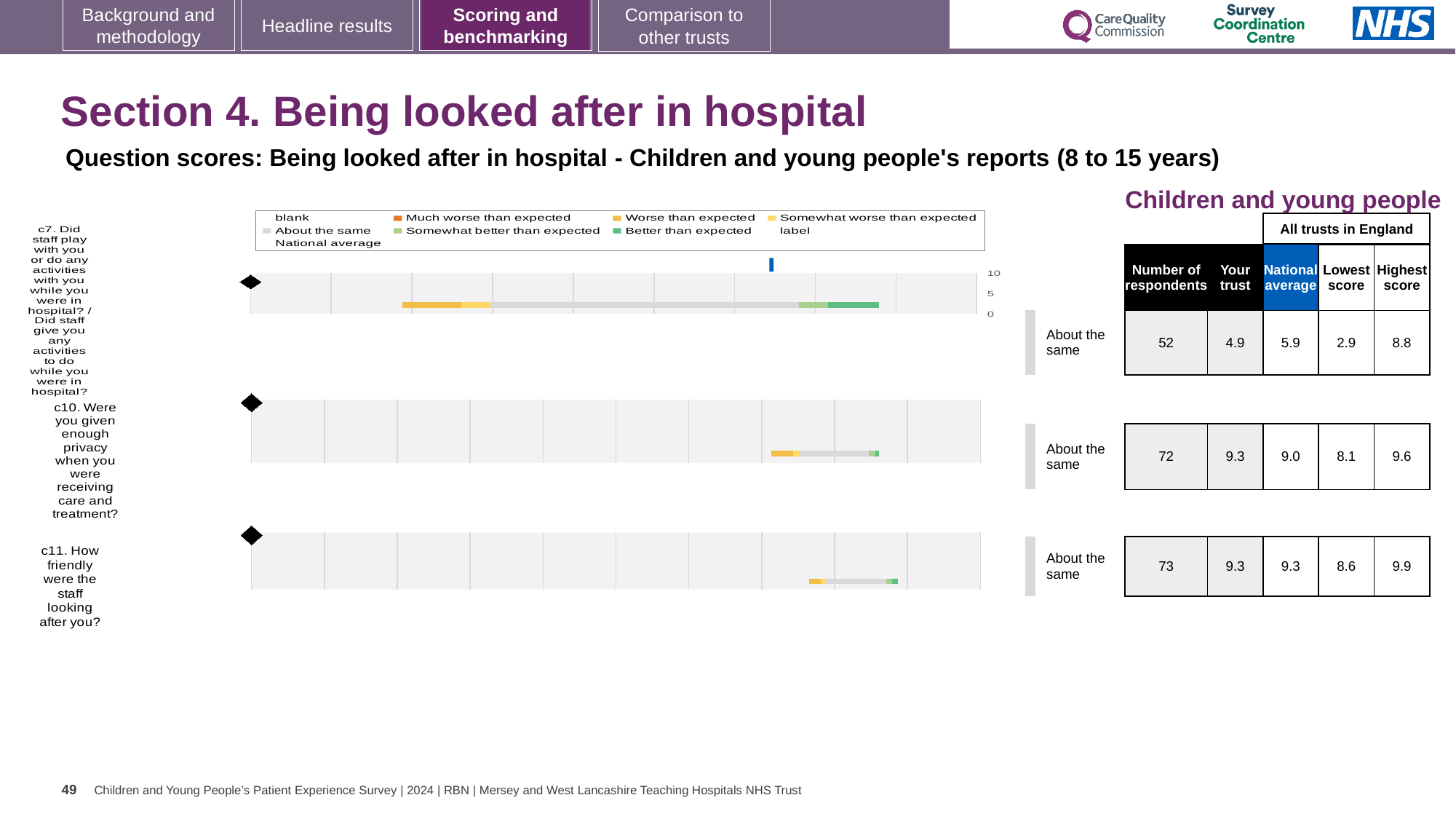
For question c7, how much lower is the 'Your trust' score than the national average? 1.0 For question c7 (Did staff play with you or do any activities with you while you were in hospital?), how many respondents are shown? 52 For question c10 (Were you given enough privacy when you were receiving care and treatment?), what is the 'Your trust' score? 9.3 What benchmark category is shown for question c11? About the same For question c7, what is the difference between the highest score and the lowest score among all trusts in England? 5.9 For question c10, which is larger: the 'Your trust' score or the national average? Your trust Which of the three questions has the most respondents? c11 For question c7, what is the lowest score among all trusts in England? 2.9 For question c11 (How friendly were the staff looking after you?), what is the national average score? 9.3 Which of the three questions has the lowest 'Your trust' score? c7 For question c10, what is the highest score among all trusts in England? 9.6 How many survey questions are charted on this slide? 3